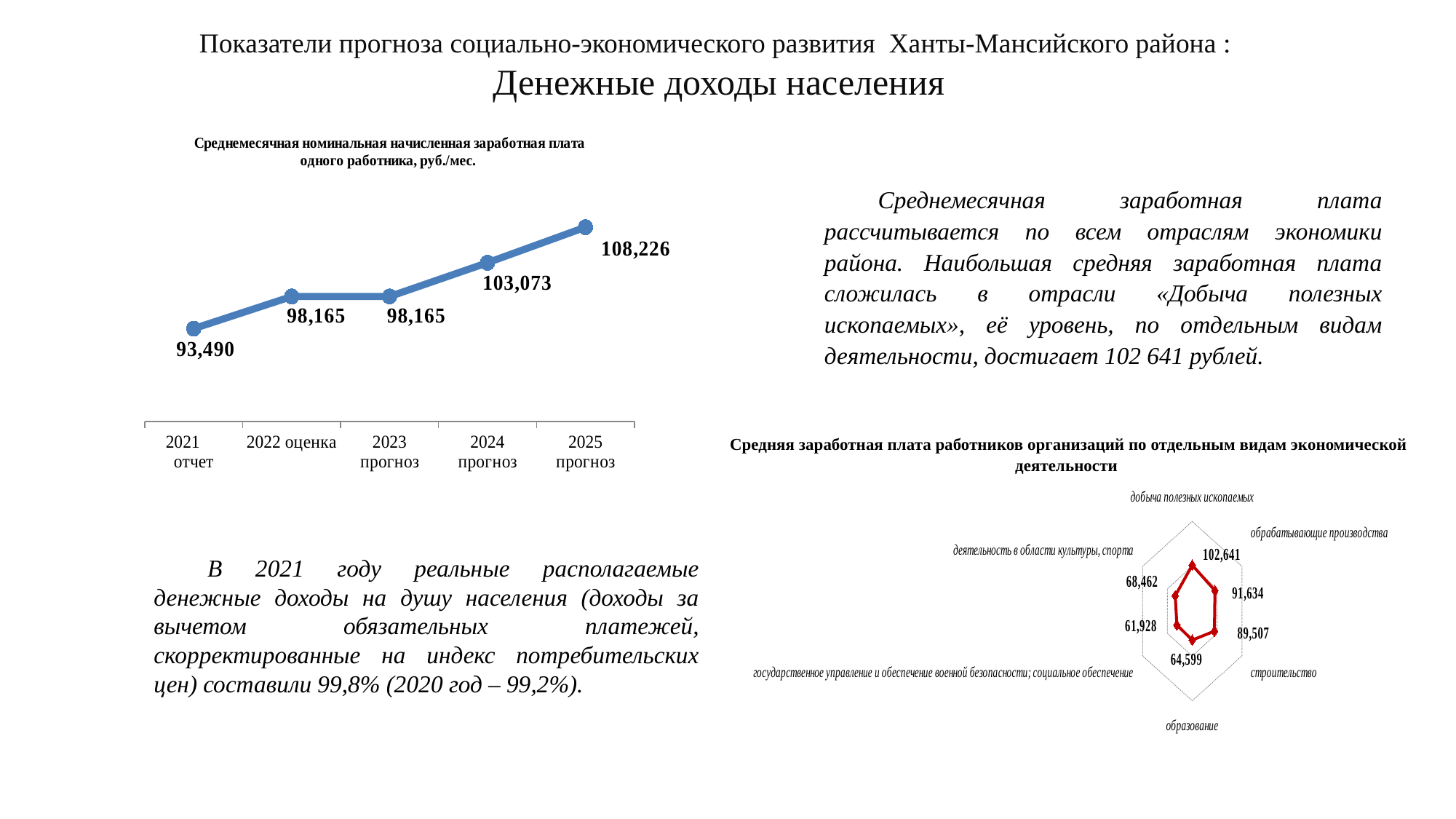
In the chart 'Среднемесячная номинальная начисленная заработная плата одного работника, руб./мес.', do the values generally rise or fall from 2021 to 2025? Rise In the chart 'Средняя заработная плата работников организаций по отдельным видам экономической деятельности', what is the value for добыча полезных ископаемых? 102,641 In the chart 'Среднемесячная номинальная начисленная заработная плата одного работника, руб./мес.', what is the value for 2024 прогноз? 103,073 In the chart 'Среднемесячная номинальная начисленная заработная плата одного работника, руб./мес.', which period has the lowest value? 2021 отчет What type of chart is 'Среднемесячная номинальная начисленная заработная плата одного работника, руб./мес.'? Line chart In the chart 'Средняя заработная плата работников организаций по отдельным видам экономической деятельности', which activity has the lowest value? государственное управление и обеспечение военной безопасности; социальное обеспечение In the chart 'Среднемесячная номинальная начисленная заработная плата одного работника, руб./мес.', what is the value for 2025 прогноз? 108,226 In the chart 'Средняя заработная плата работников организаций по отдельным видам экономической деятельности', how many types of economic activity are shown? 6 In the chart 'Среднемесячная номинальная начисленная заработная плата одного работника, руб./мес.', what is the difference between the 2025 прогноз and 2021 отчет values? 14,736 In the chart 'Средняя заработная плата работников организаций по отдельным видам экономической деятельности', which is larger: обрабатывающие производства or строительство? обрабатывающие производства In the chart 'Среднемесячная номинальная начисленная заработная плата одного работника, руб./мес.', how many data points are plotted? 5 In the chart 'Среднемесячная номинальная начисленная заработная плата одного работника, руб./мес.', what is the value for 2021 отчет? 93,490